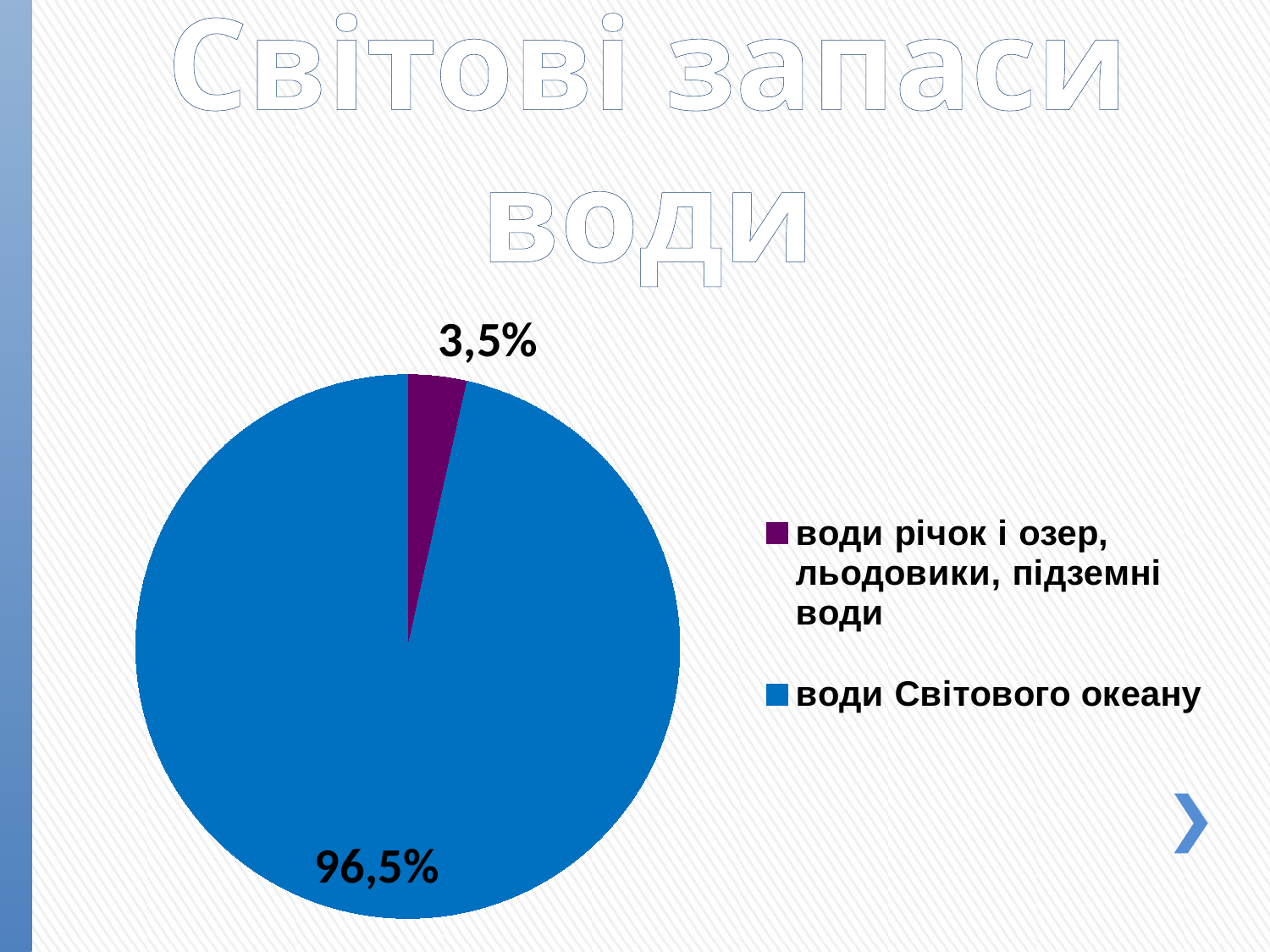
Which category has the largest slice of the pie? води Світового океану What is the difference between the share for "води Світового океану" and the share for "води річок і озер, льодовики, підземні води"? 93% How many entries does the legend list? 2 What colour is the slice for "води Світового океану"? blue What share of the pie is labelled for "води Світового океану"? 96,5% What is the title of the slide containing the pie chart? Світові запаси води Which is larger: the slice for "води Світового океану" or the slice for "води річок і озер, льодовики, підземні води"? води Світового океану How many slices does the pie chart have? 2 Which category has the smallest slice of the pie? води річок і озер, льодовики, підземні води What share of the pie is labelled for "води річок і озер, льодовики, підземні води"? 3,5% What kind of chart is shown on the slide? pie chart